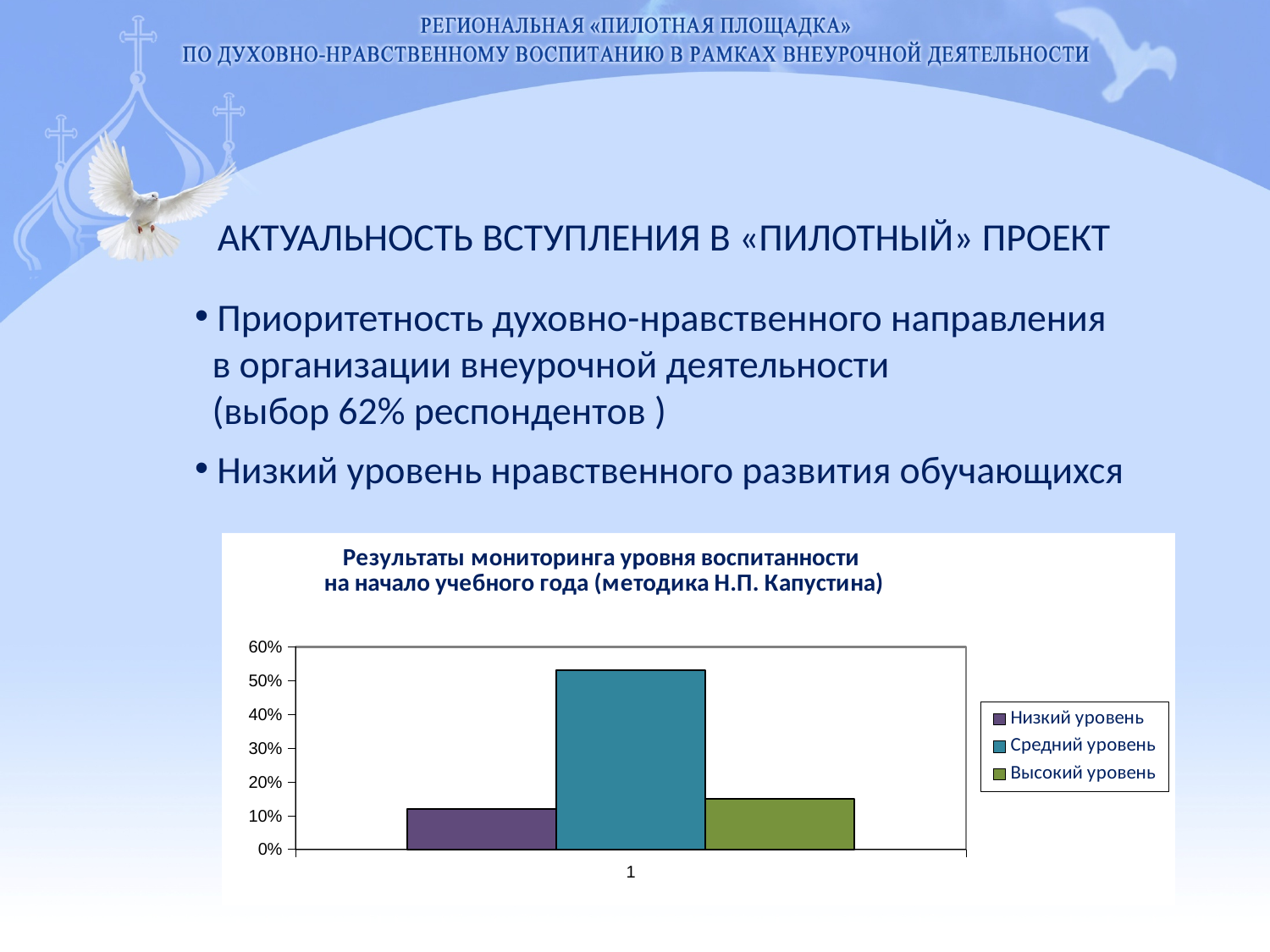
Is the value for Высокий уровень greater or less than 10%? greater Is the value for Средний уровень greater or less than 50%? greater What is the title of the chart? Результаты мониторинга уровня воспитанности на начало учебного года (методика Н.П. Капустина) How many series does the chart legend list? 3 Which is larger, the value for Высокий уровень or the value for Низкий уровень? Высокий уровень Which series has the highest value in the chart? Средний уровень Which series has the lowest value in the chart? Низкий уровень Is the value for Средний уровень greater or less than 60%? less What kind of chart is shown on the slide? bar chart How many categories are shown on the x axis of the chart? 1